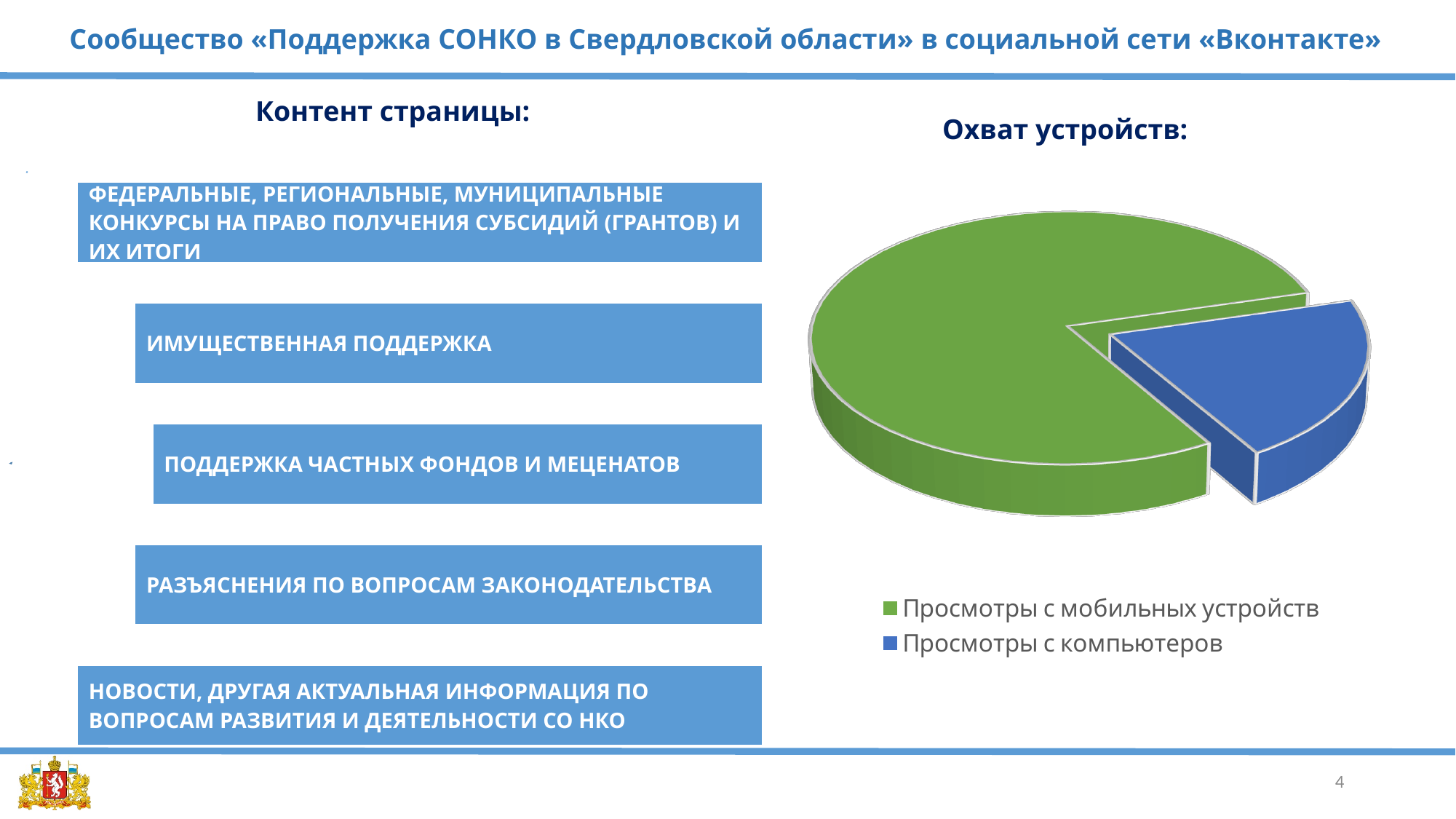
In the pie chart «Охват устройств:», what colour is the slice for «Просмотры с мобильных устройств»? green In the pie chart «Охват устройств:», what colour is the slice for «Просмотры с компьютеров»? blue What kind of chart is shown under the heading «Охват устройств:»? pie chart In the pie chart «Охват устройств:», which category has the smallest slice? Просмотры с компьютеров How many slices does the pie chart «Охват устройств:» have? 2 How many entries does the legend of the pie chart «Охват устройств:» list? 2 In the pie chart «Охват устройств:», which category has the largest slice? Просмотры с мобильных устройств In the pie chart «Охват устройств:», which is larger: «Просмотры с мобильных устройств» or «Просмотры с компьютеров»? Просмотры с мобильных устройств